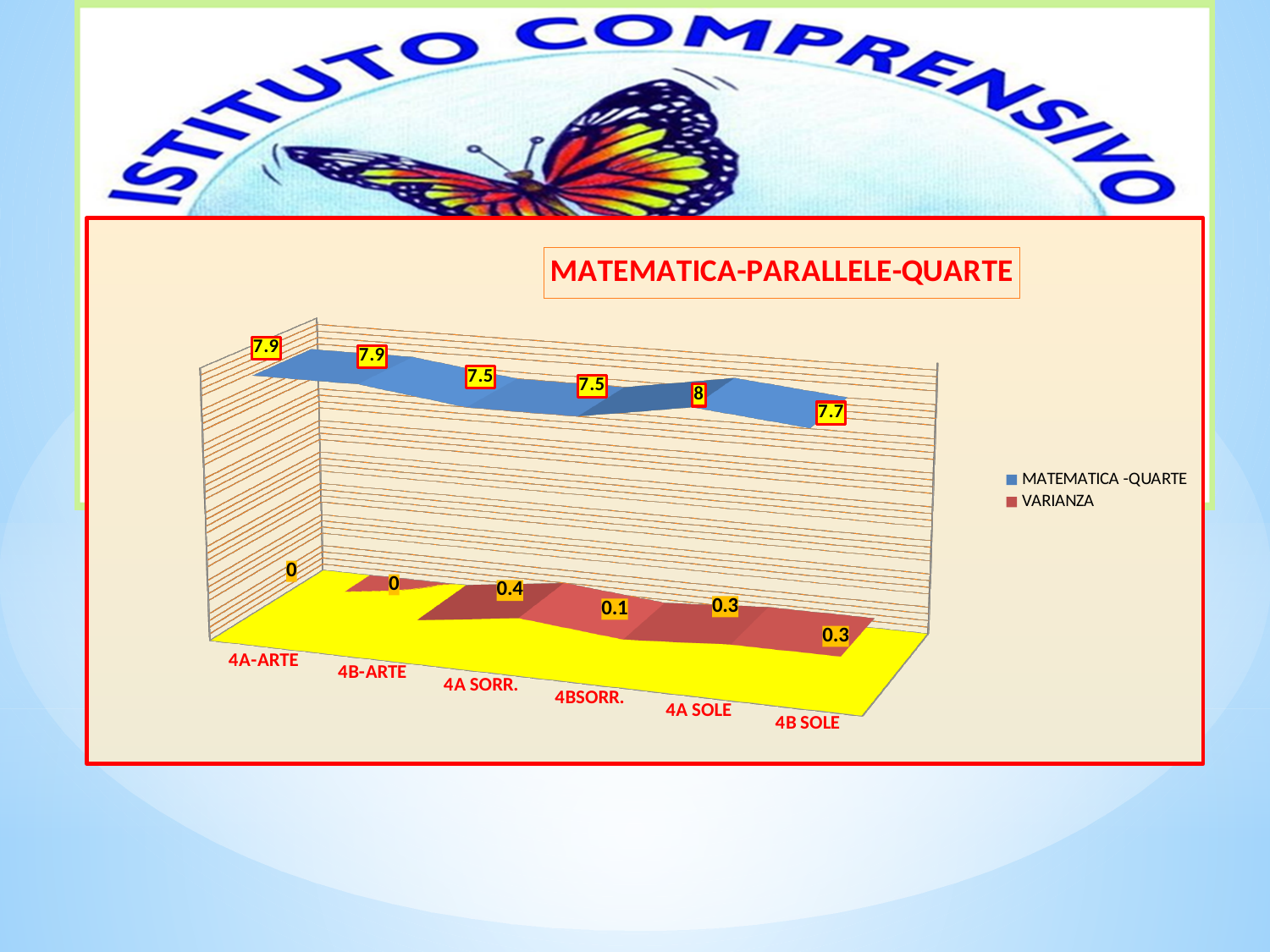
Which is larger, the MATEMATICA -QUARTE value for 4A-ARTE or for 4B SOLE? 4A-ARTE What is the difference between the MATEMATICA -QUARTE values for 4A SOLE and 4A SORR.? 0.5 Which category has the highest MATEMATICA -QUARTE value? 4A SOLE What kind of chart is shown? 3D line chart What is the VARIANZA value for 4BSORR.? 0.1 What is the title of the chart? MATEMATICA-PARALLELE-QUARTE What is the MATEMATICA -QUARTE value for 4A SOLE? 8 How many categories are shown on the x axis? 6 What is the MATEMATICA -QUARTE value for 4B SOLE? 7.7 How many series does the legend list? 2 What is the VARIANZA value for 4A SORR.? 0.4 Which category has the highest VARIANZA value? 4A SORR.